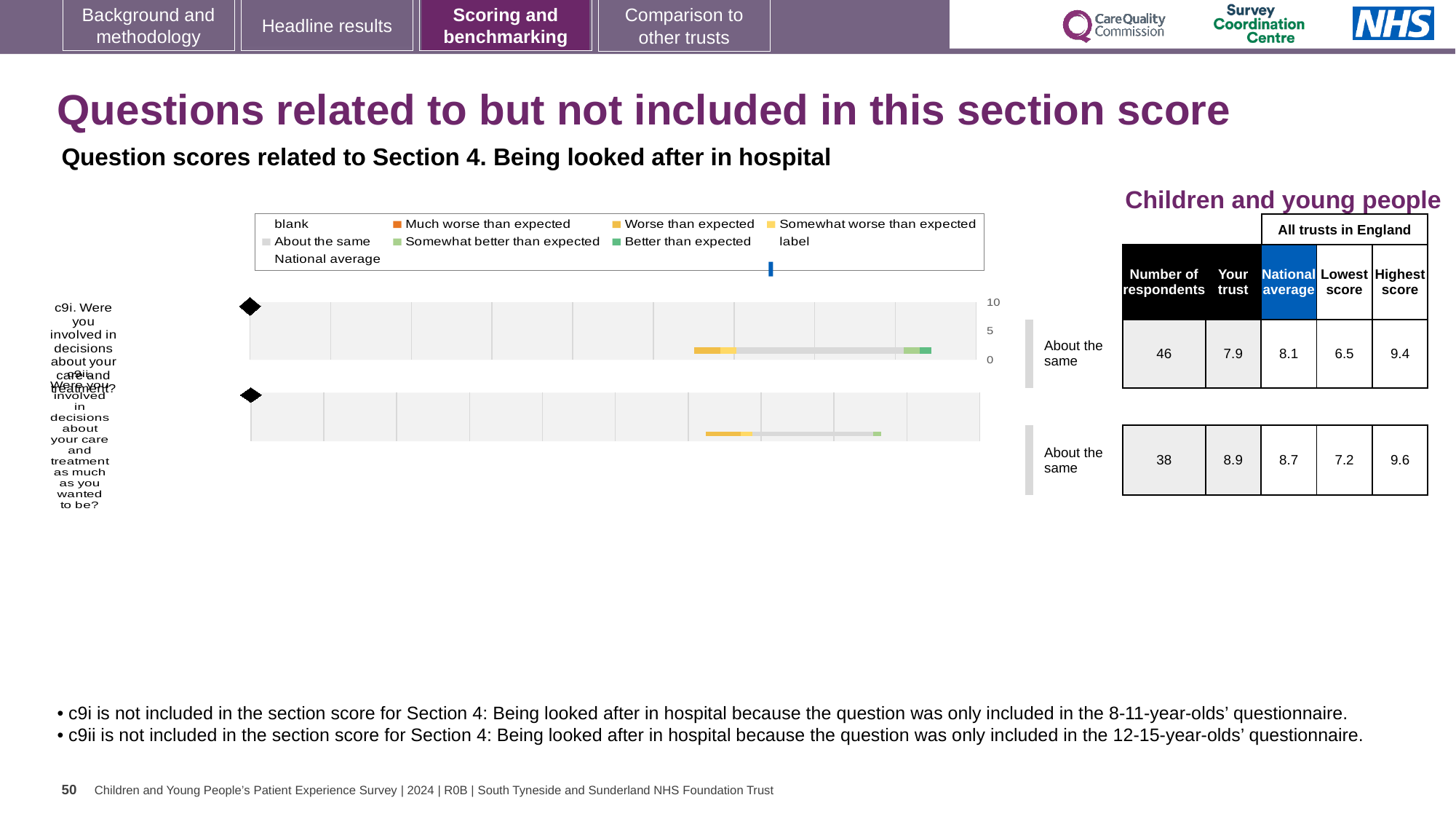
What is the national average score for c9ii in the table beside the chart? 8.7 What is the highest score across all trusts in England for c9ii? 9.6 For c9i, which is larger: the 'Your trust' score or the national average? National average How many respondents are listed for c9i? 46 What is the benchmark category shown next to the bar for c9i? About the same What kind of chart is shown on the slide? bar chart Which legend entry is shown in dark orange? Much worse than expected How many questions (bars) are plotted in the chart? 2 What is the 'Your trust' score for c9i in the table beside the chart? 7.9 What is the difference between the highest score and the lowest score for c9i? 2.9 What colour is the 'National average' marker in the chart legend? blue Which question has more respondents, c9i or c9ii? c9i